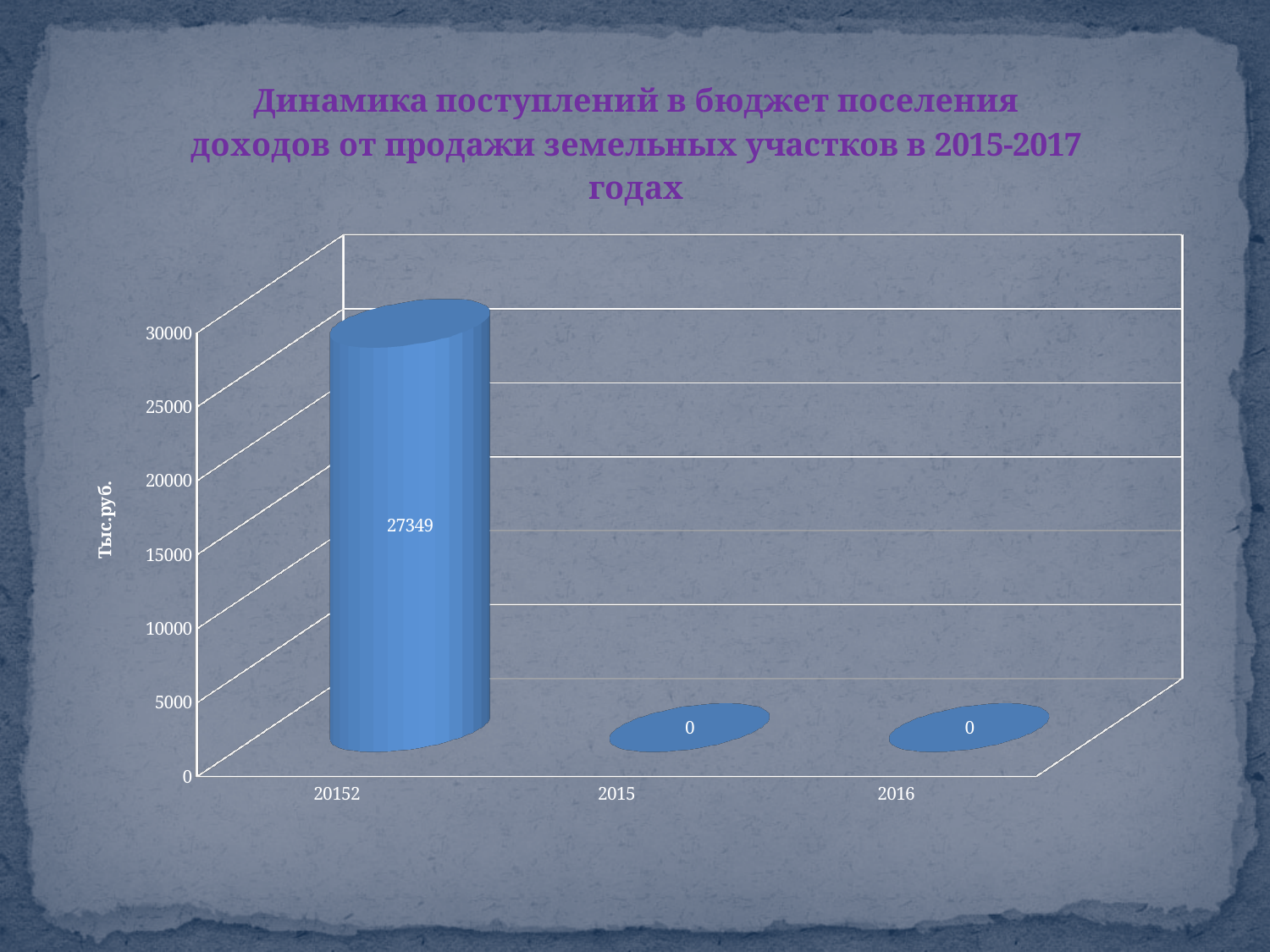
What is the highest tick value shown on the vertical axis? 30000 What is the total of the values for 2015 and 2016? 0 Is the value for 20152 greater or less than 25000? greater What is the value for 2016? 0 What kind of chart is shown on the slide? bar chart What is the value for 2015? 0 Which is larger, the value for 20152 or the value for 2016? 20152 What is the value for the category labelled 20152? 27349 How many categories are shown on the x axis? 3 Which category has the highest value? 20152 What is the label on the vertical axis? Тыс.руб. What is the difference between the value for 20152 and the value for 2015? 27349